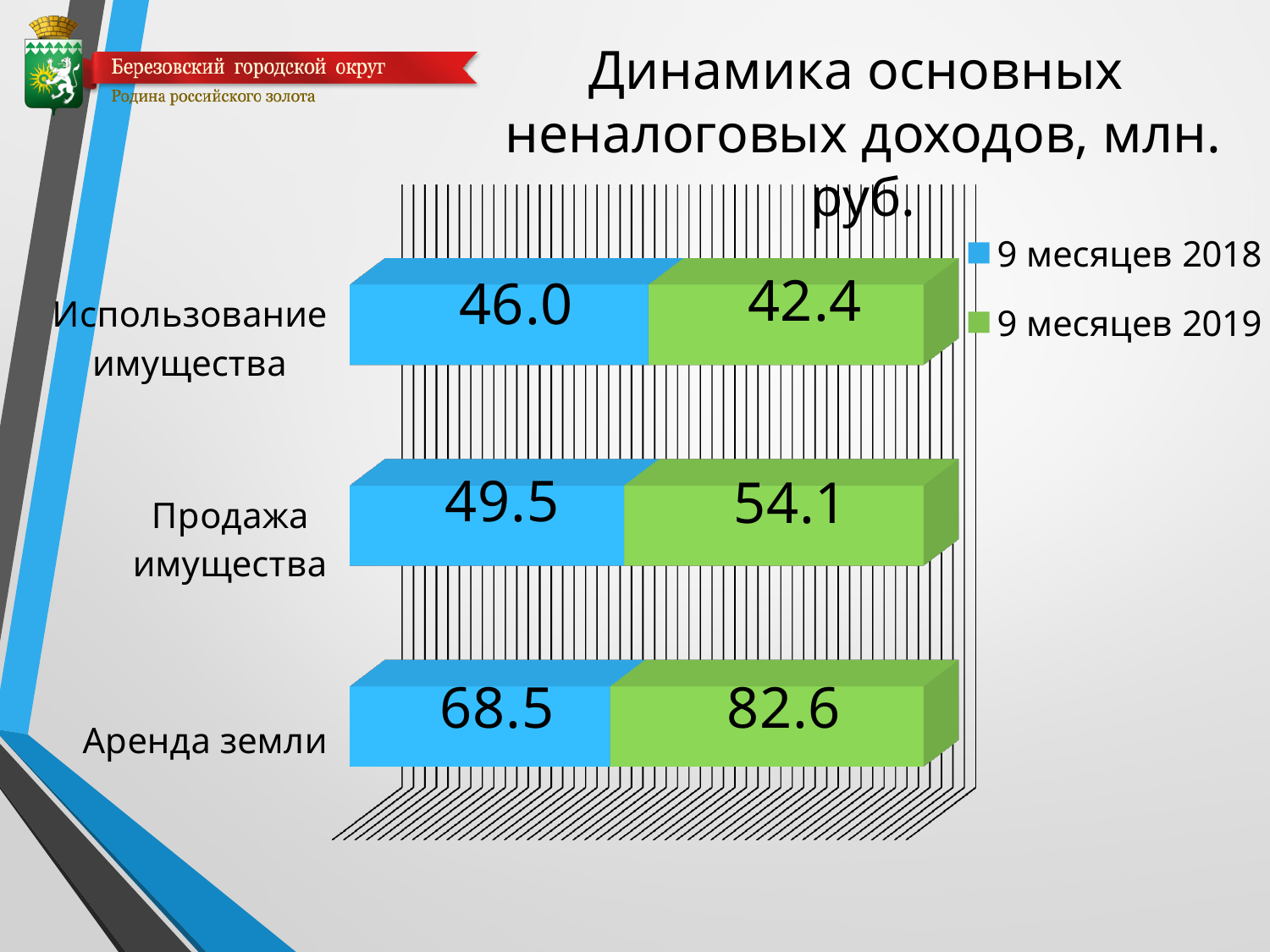
What is the value for Продажа имущества in the 9 месяцев 2019 series? 54.1 What is the combined total of the two series for Продажа имущества? 103.6 Which category has the lowest value in the 9 месяцев 2018 series? Использование имущества What is the value for Аренда земли in the 9 месяцев 2019 series? 82.6 What is the difference between the 9 месяцев 2018 and 9 месяцев 2019 values for Использование имущества? 3.6 How many series does the legend list? 2 What is the value for Использование имущества in the 9 месяцев 2018 series? 46.0 What is the difference between the 9 месяцев 2019 and 9 месяцев 2018 values for Аренда земли? 14.1 Which category has the highest value in the 9 месяцев 2019 series? Аренда земли For Продажа имущества, which is larger: the 9 месяцев 2018 value or the 9 месяцев 2019 value? 9 месяцев 2019 What kind of chart is shown on the slide? Stacked bar chart How many categories are shown on the chart? 3